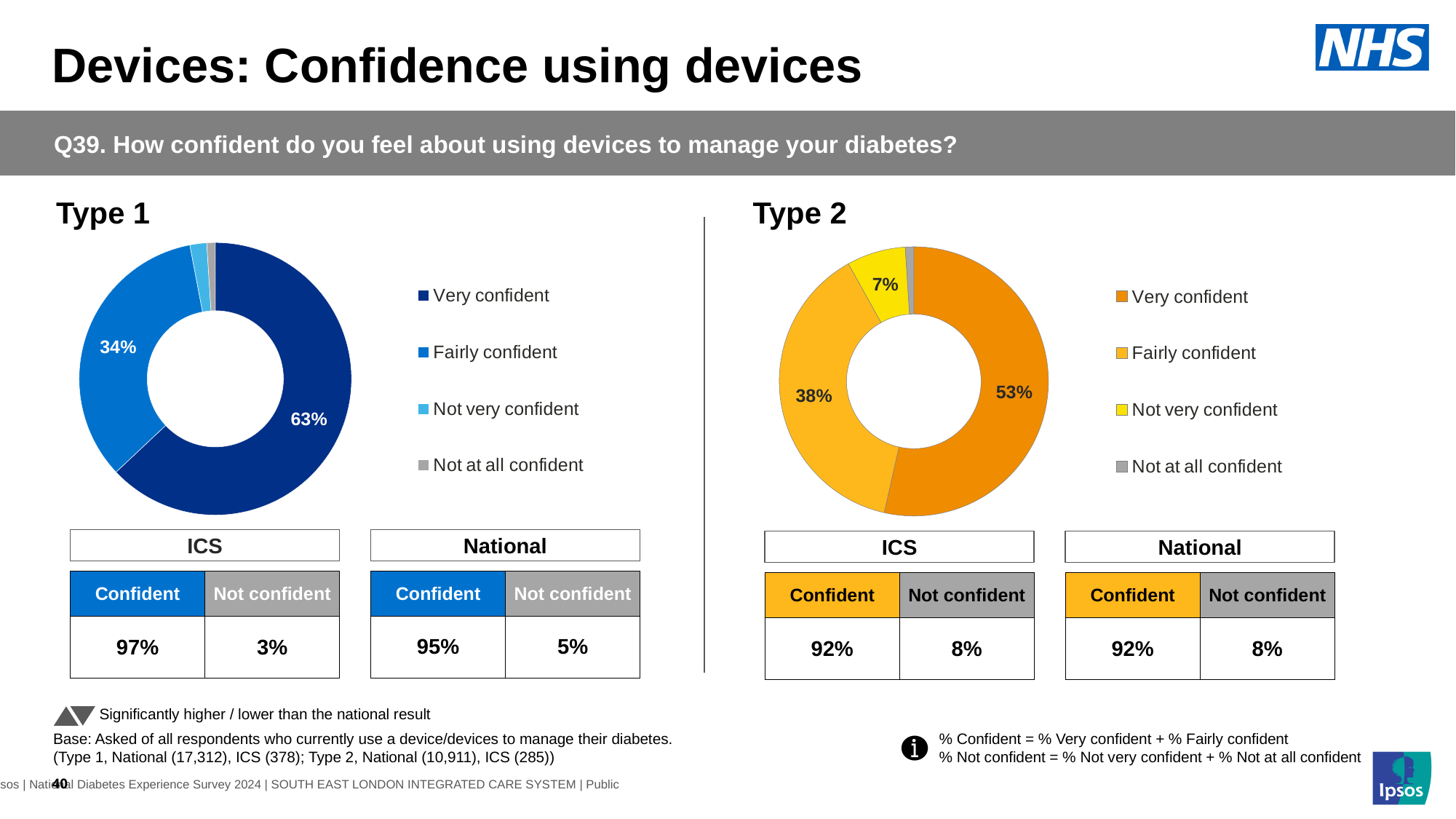
How many categories does the legend of the Type 1 chart list? 4 In the Type 2 chart, what percentage of respondents are Not very confident? 7% What kind of chart is used for Type 2? Donut (pie) chart In the Type 2 chart, which category has the smallest share? Not at all confident In the Type 1 chart, which category has the largest share? Very confident In the Type 1 chart, what is the difference in percentage points between Very confident and Fairly confident? 29 In the Type 1 chart, what percentage of respondents are Fairly confident? 34% In the Type 2 chart, which is larger: Fairly confident or Not very confident? Fairly confident In the Type 2 chart, what percentage of respondents are Very confident? 53% In the Type 2 chart, what is the difference in percentage points between Very confident and Fairly confident? 15 In the Type 2 chart, what colour represents Not very confident? Yellow In the Type 1 chart, what percentage of respondents are Very confident? 63%